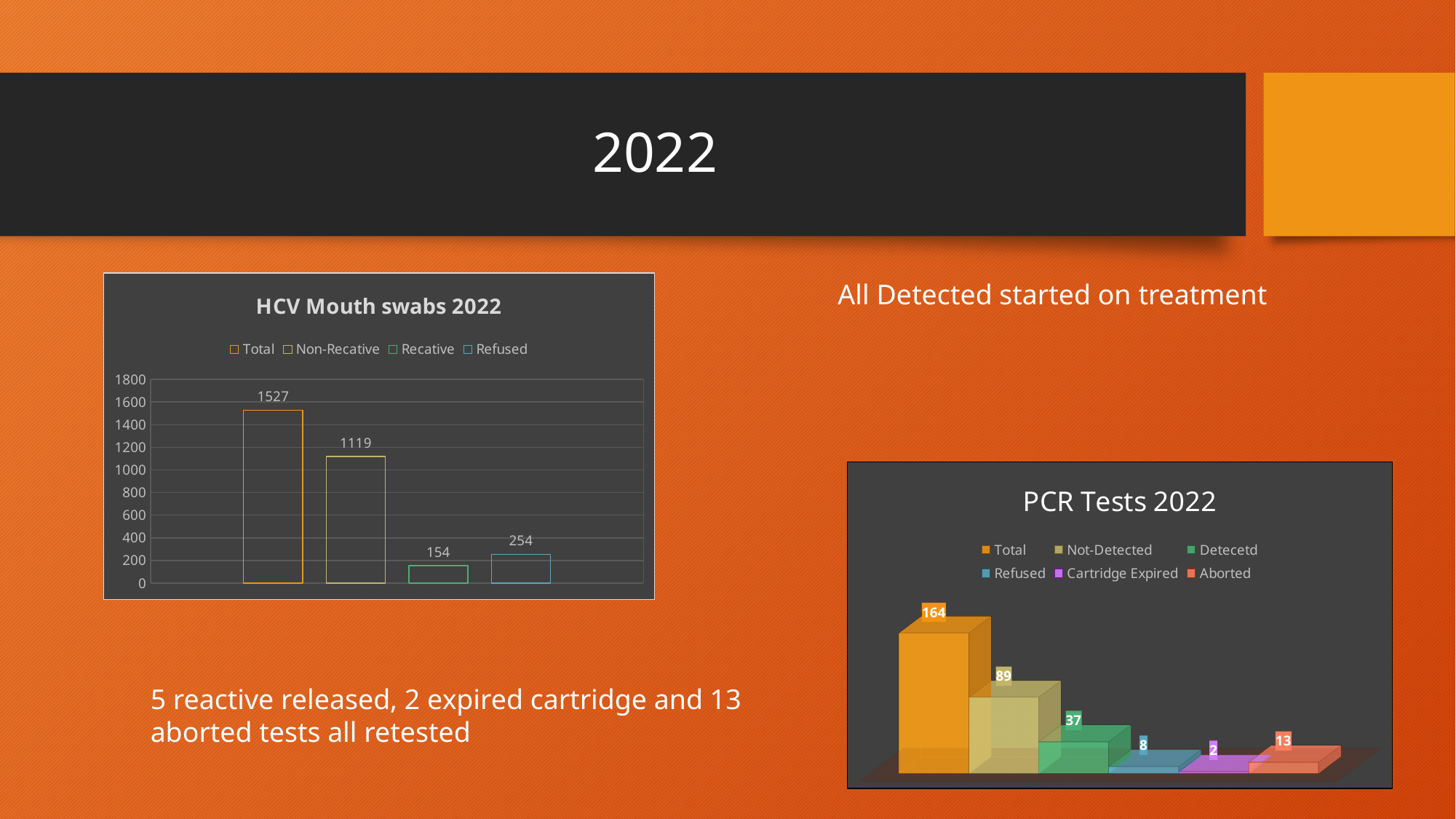
In the 'HCV Mouth swabs 2022' chart, how many series does the legend list? 4 In the 'HCV Mouth swabs 2022' chart, which is larger, Recative or Refused? Refused In the 'HCV Mouth swabs 2022' chart, which series has the lowest value? Recative In the 'PCR Tests 2022' chart, which series has the highest value? Total In the 'HCV Mouth swabs 2022' chart, what is the value for Refused? 254 In the 'PCR Tests 2022' chart, what is the difference between Detecetd and Aborted? 24 In the 'HCV Mouth swabs 2022' chart, what is the difference between Total and Non-Recative? 408 What kind of chart is 'PCR Tests 2022'? Bar chart In the 'HCV Mouth swabs 2022' chart, what is the value for Total? 1527 In the 'PCR Tests 2022' chart, what is the value for Not-Detected? 89 In the 'HCV Mouth swabs 2022' chart, what is the value for Non-Recative? 1119 In the 'PCR Tests 2022' chart, what is the value for Cartridge Expired? 2